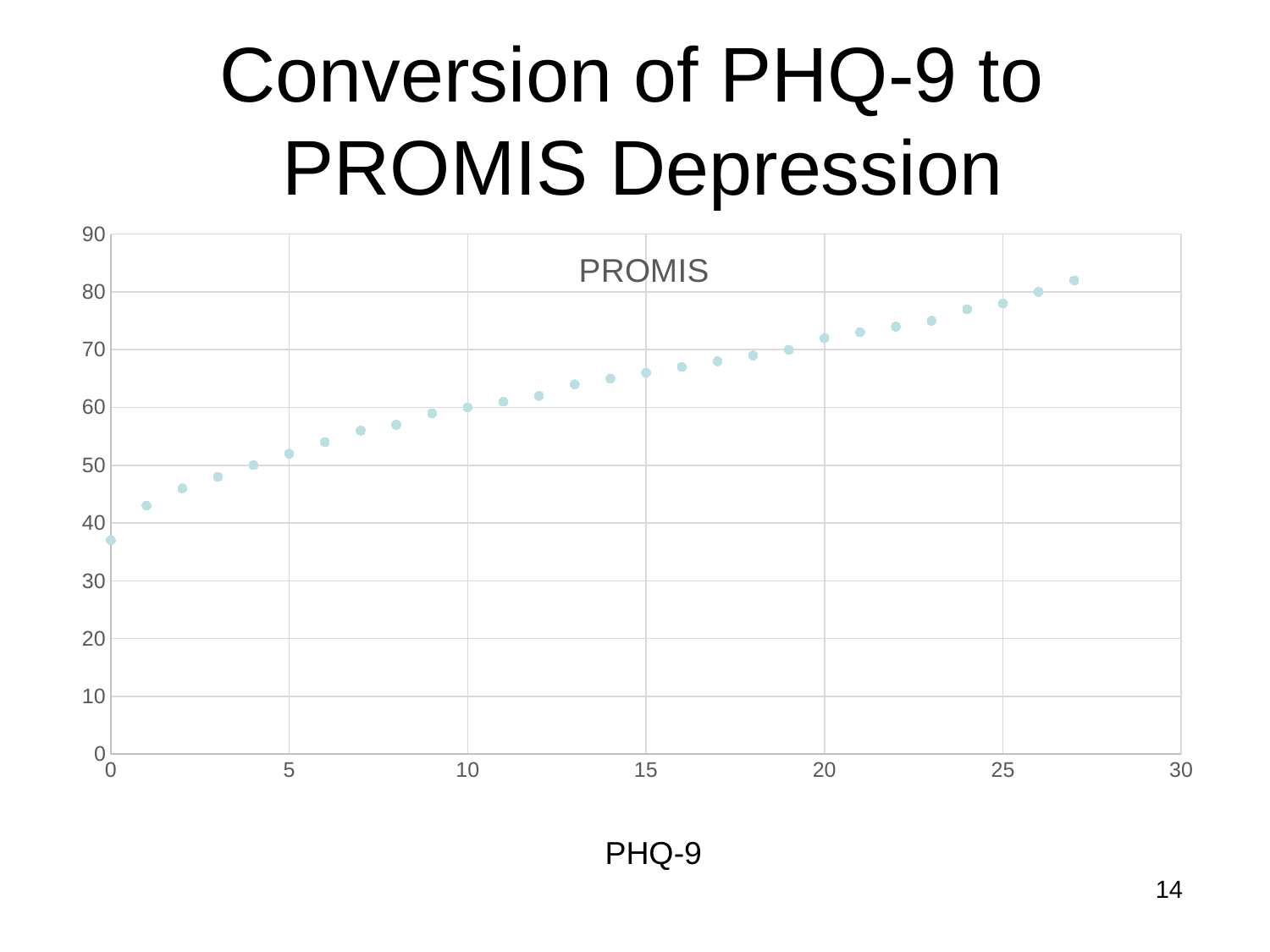
What kind of chart is shown on the slide? scatter chart Is the PROMIS value at a PHQ-9 score of 0 greater or less than 40? less What is the PROMIS value at a PHQ-9 score of 4? 50 What is the title of the chart? PROMIS What is the PROMIS value at a PHQ-9 score of 10? 60 How many data points are plotted on the chart? 28 What is the label on the x axis of the chart? PHQ-9 Is the PROMIS value at a PHQ-9 score of 27 greater or less than 80? greater Do the PROMIS values rise or fall as the PHQ-9 score increases? rise At which PHQ-9 score is the PROMIS value lowest? 0 Which has the larger PROMIS value: a PHQ-9 score of 5 or a PHQ-9 score of 20? 20 At which PHQ-9 score is the PROMIS value highest? 27